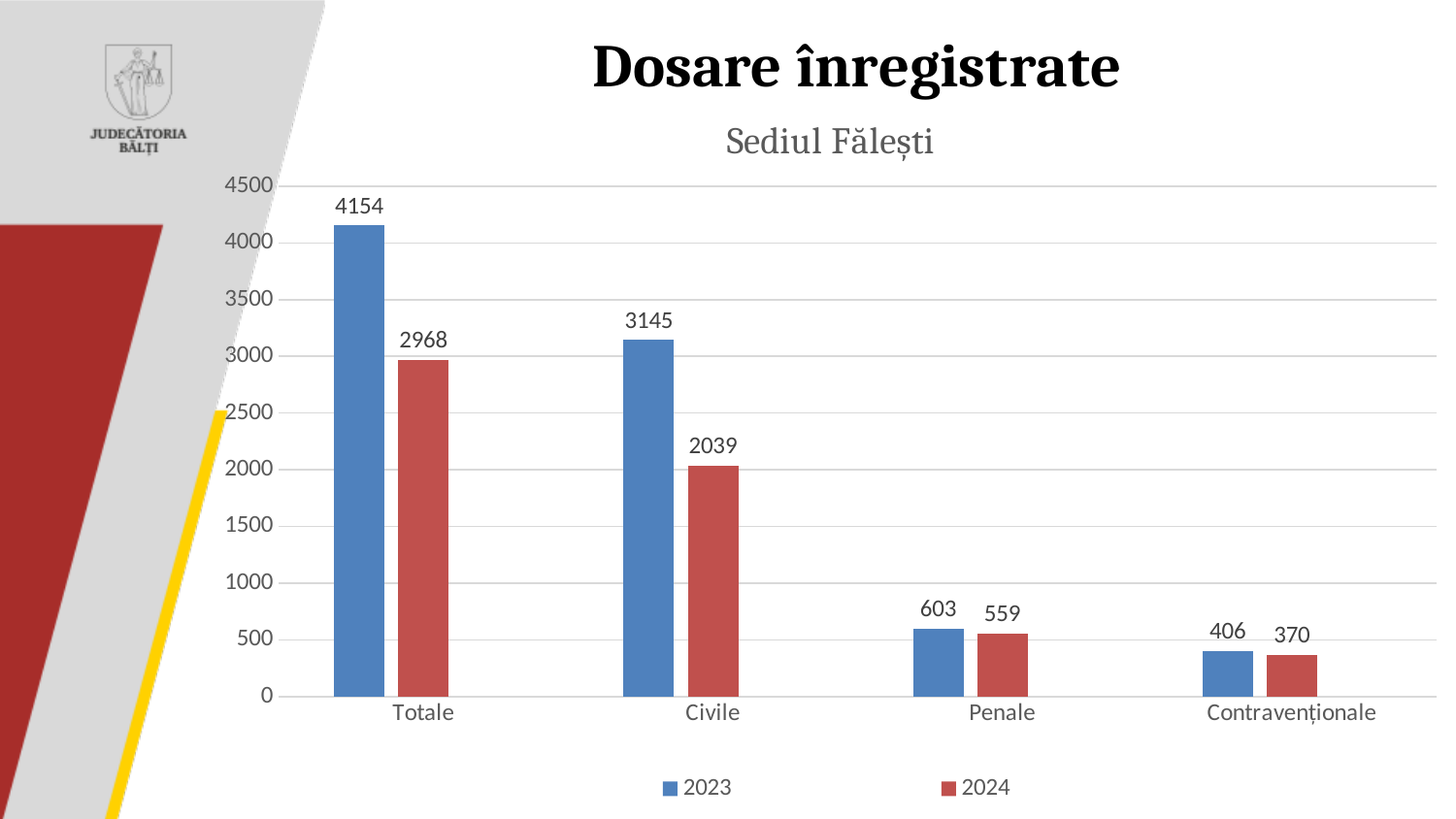
What is the value for Penale in 2023? 603 What is the value for Contravenționale in 2024? 370 How many categories are shown on the x axis? 4 What kind of chart is shown on the slide? Bar chart Which category has the lowest value in 2024? Contravenționale Which is larger, the 2023 value for Civile or the 2024 value for Totale? 2023 value for Civile What is the value for Totale in 2023? 4154 What is the value for Civile in 2024? 2039 What is the difference between the 2023 and 2024 values for Penale? 44 Which category has the highest value in 2023? Totale What is the difference between the 2023 and 2024 values for Totale? 1186 How many series does the legend list? 2